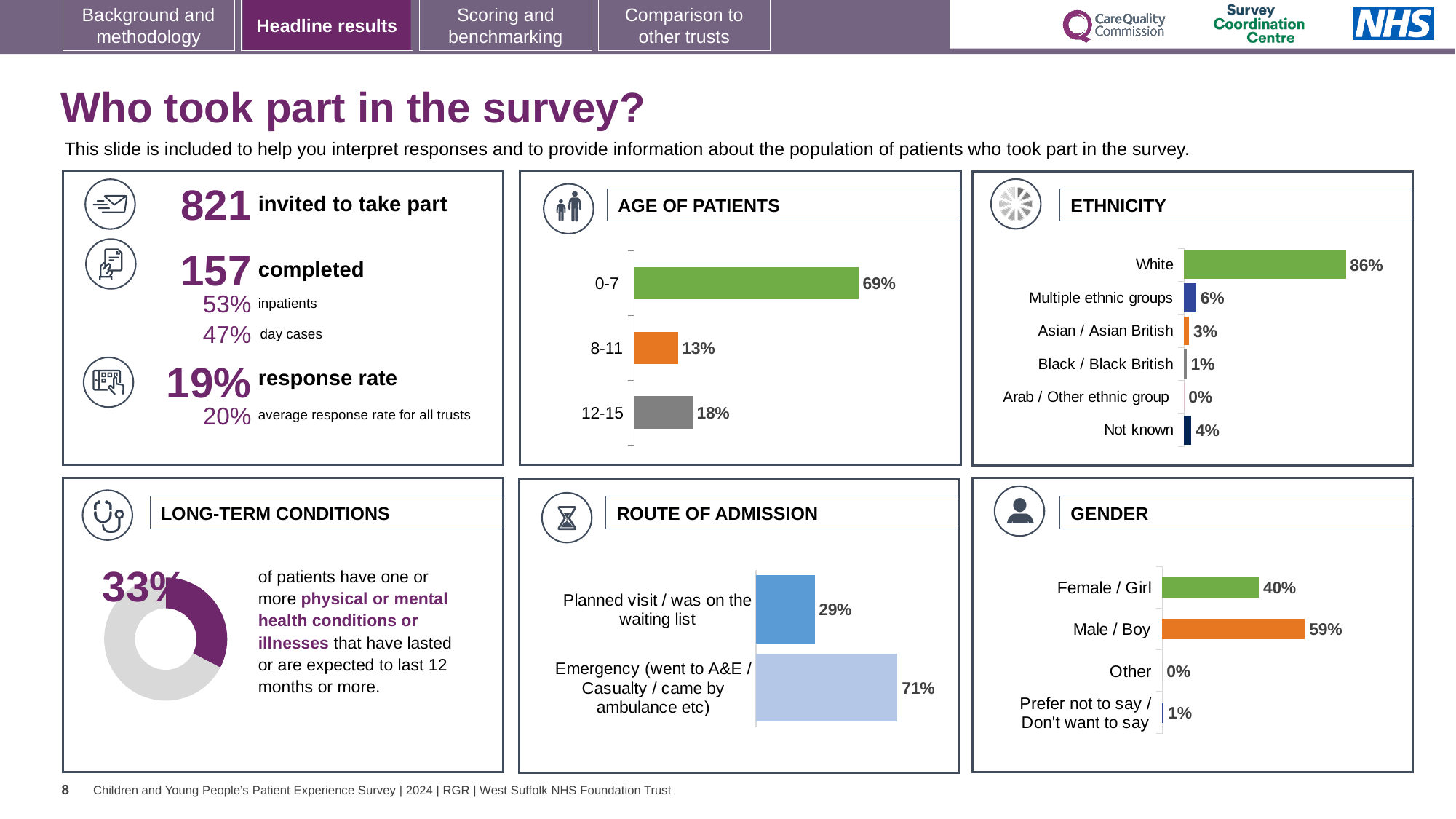
In the ETHNICITY chart, how many ethnicity categories are shown? 6 In the AGE OF PATIENTS chart, what is the difference between the 12-15 and 8-11 percentages? 5% In the GENDER chart, what percentage of patients were Male / Boy? 59% In the AGE OF PATIENTS chart, which age group has the lowest percentage? 8-11 In the ROUTE OF ADMISSION chart, what percentage of patients were emergency admissions? 71% In the ETHNICITY chart, which category has the highest percentage? White In the ETHNICITY chart, which is larger: Multiple ethnic groups or Not known? Multiple ethnic groups What type of chart is used in the LONG-TERM CONDITIONS panel? Donut chart In the ROUTE OF ADMISSION chart, what is the difference between the Emergency and Planned visit percentages? 42% In the AGE OF PATIENTS chart, what percentage of patients were aged 0-7? 69% In the GENDER chart, which is larger: Female / Girl or Male / Boy? Male / Boy In the ETHNICITY chart, what percentage of patients were White? 86%